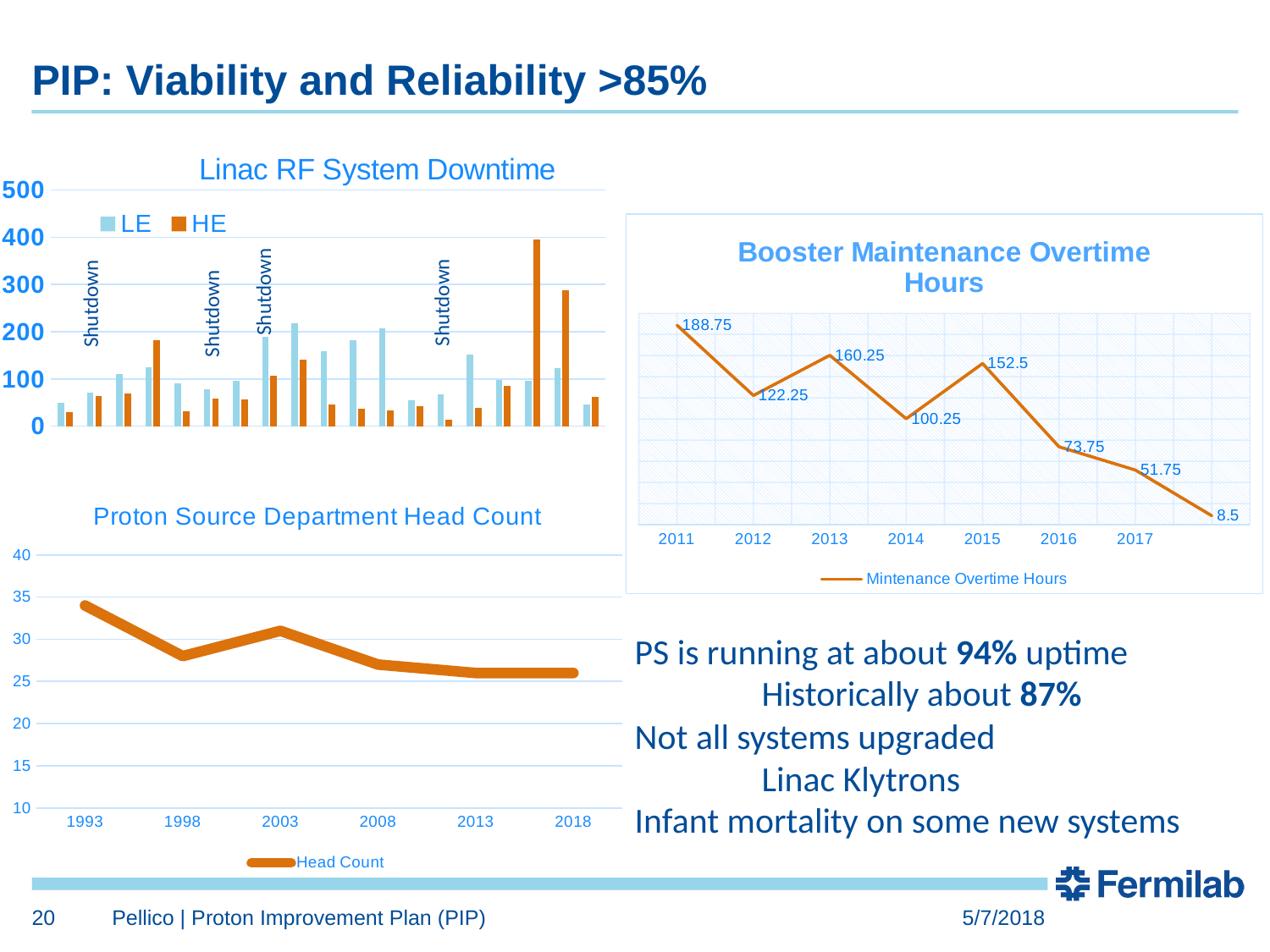
What kind of chart is the Linac RF System Downtime chart? Bar chart What kind of chart is the Proton Source Department Head Count chart? Line chart In the Proton Source Department Head Count chart, do the values generally rise or fall from 1993 to 2018? Fall In the Booster Maintenance Overtime Hours chart, what is the value for 2011? 188.75 In the Booster Maintenance Overtime Hours chart, how many data points are plotted? 8 In the Booster Maintenance Overtime Hours chart, which year has the highest overtime hours? 2011 In the Booster Maintenance Overtime Hours chart, which is larger, the value for 2013 or the value for 2015? 2013 In the Booster Maintenance Overtime Hours chart, what is the value for 2014? 100.25 In the Proton Source Department Head Count chart, is the value for 1993 greater or less than 30? greater In the Booster Maintenance Overtime Hours chart, what is the difference between the 2011 and 2012 values? 66.5 In the Booster Maintenance Overtime Hours chart, what is the lowest value plotted? 8.5 How many series does the legend of the Linac RF System Downtime chart list? 2